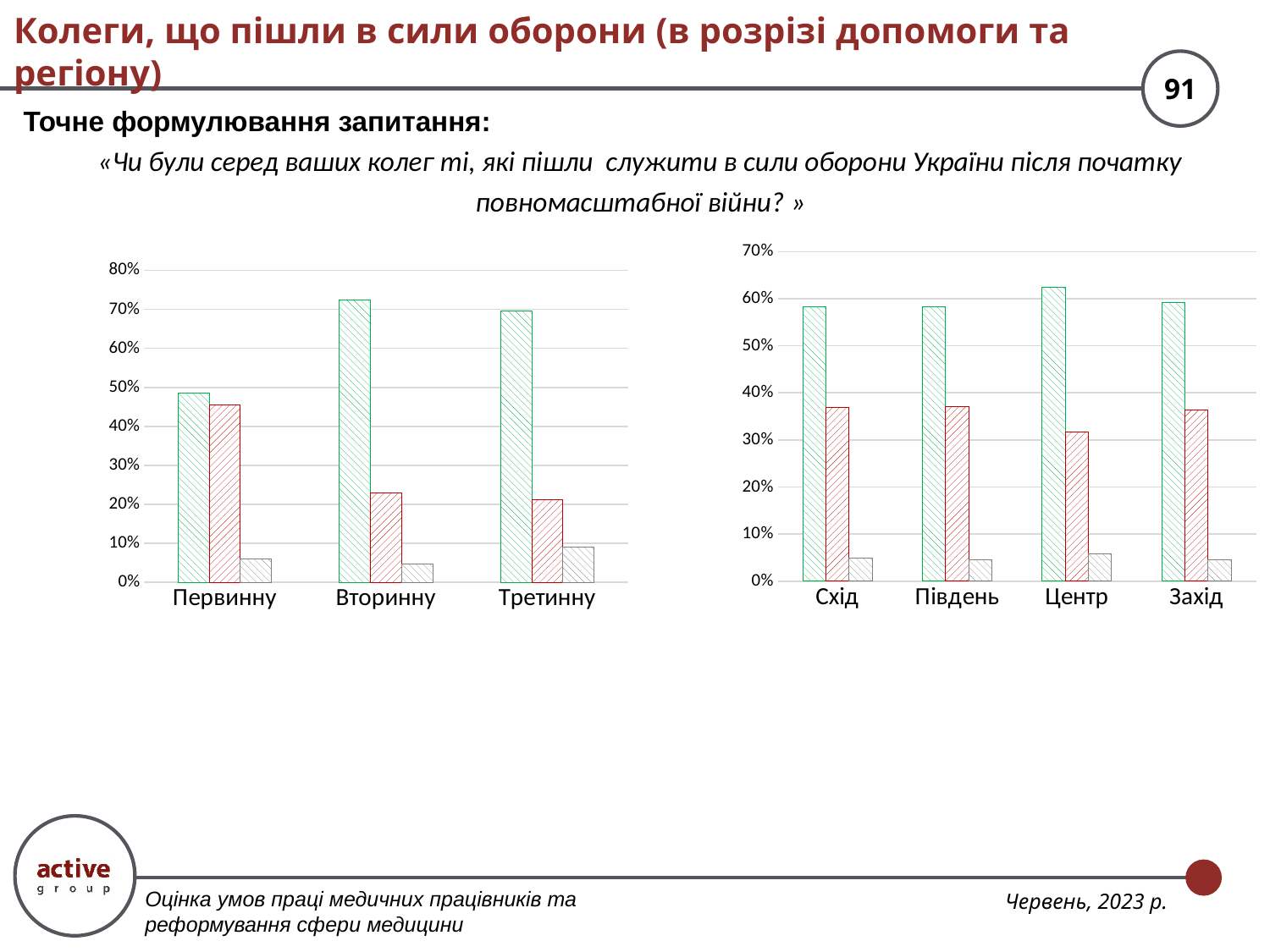
In the right chart, which region has the tallest green bar? Центр In the left chart, which category has the tallest green bar? Вторинну In the right chart, which region has the lowest red bar? Центр In the left chart, which is larger: the red bar for Первинну or the red bar for Вторинну? Первинну How many categories are shown on the x axis of the right chart (Схід, Південь, Центр, Захід)? 4 In the left chart, how many bars are plotted for each category? 3 In the left chart, is the red bar for Первинну greater or less than 40%? greater What kind of chart is the left chart (Первинну, Вторинну, Третинну)? bar chart How many categories are shown on the x axis of the left chart? 3 In the right chart, is the red bar for Схід greater or less than 30%? greater In the left chart, is the green bar for Вторинну greater or less than 60%? greater